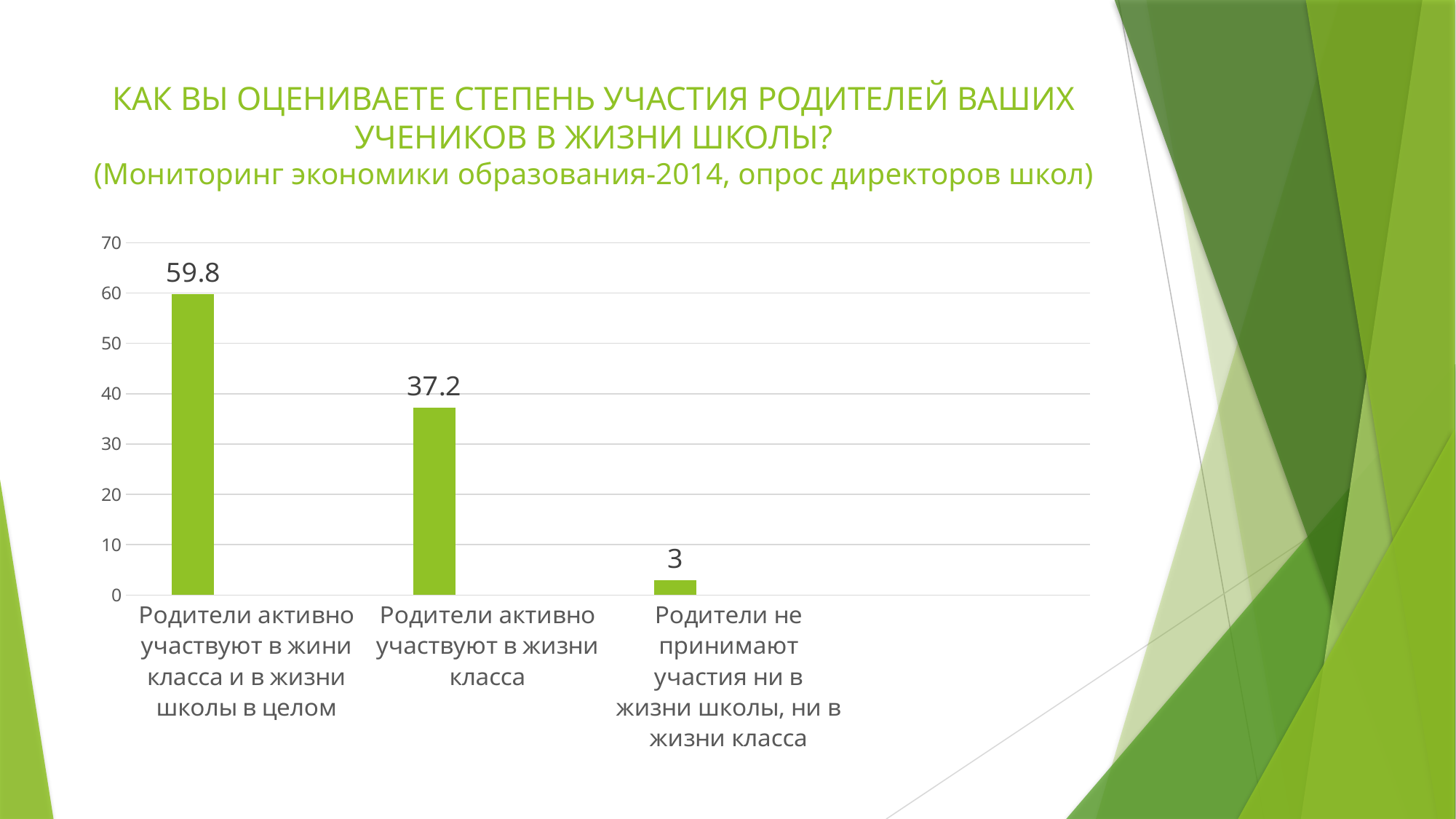
What is the value for the category 'Родители активно участвуют в жизни класса'? 37.2 Is the value for 'Родители активно участвуют в жизни класса' greater or less than 40? less Which category has the highest value? Родители активно участвуют в жини класса и в жизни школы в целом Do the values rise or fall from left to right along the x axis? fall What is the value for the category 'Родители активно участвуют в жини класса и в жизни школы в целом'? 59.8 What is the difference between the values for 'Родители активно участвуют в жини класса и в жизни школы в целом' and 'Родители активно участвуют в жизни класса'? 22.6 Which category has the lowest value? Родители не принимают участия ни в жизни школы, ни в жизни класса Which is larger: the value for 'Родители активно участвуют в жизни класса' or the value for 'Родители не принимают участия ни в жизни школы, ни в жизни класса'? Родители активно участвуют в жизни класса What is the difference between the values for 'Родители активно участвуют в жизни класса' and 'Родители не принимают участия ни в жизни школы, ни в жизни класса'? 34.2 How many categories are shown on the chart? 3 What kind of chart is shown on the slide? bar chart What is the value for the category 'Родители не принимают участия ни в жизни школы, ни в жизни класса'? 3